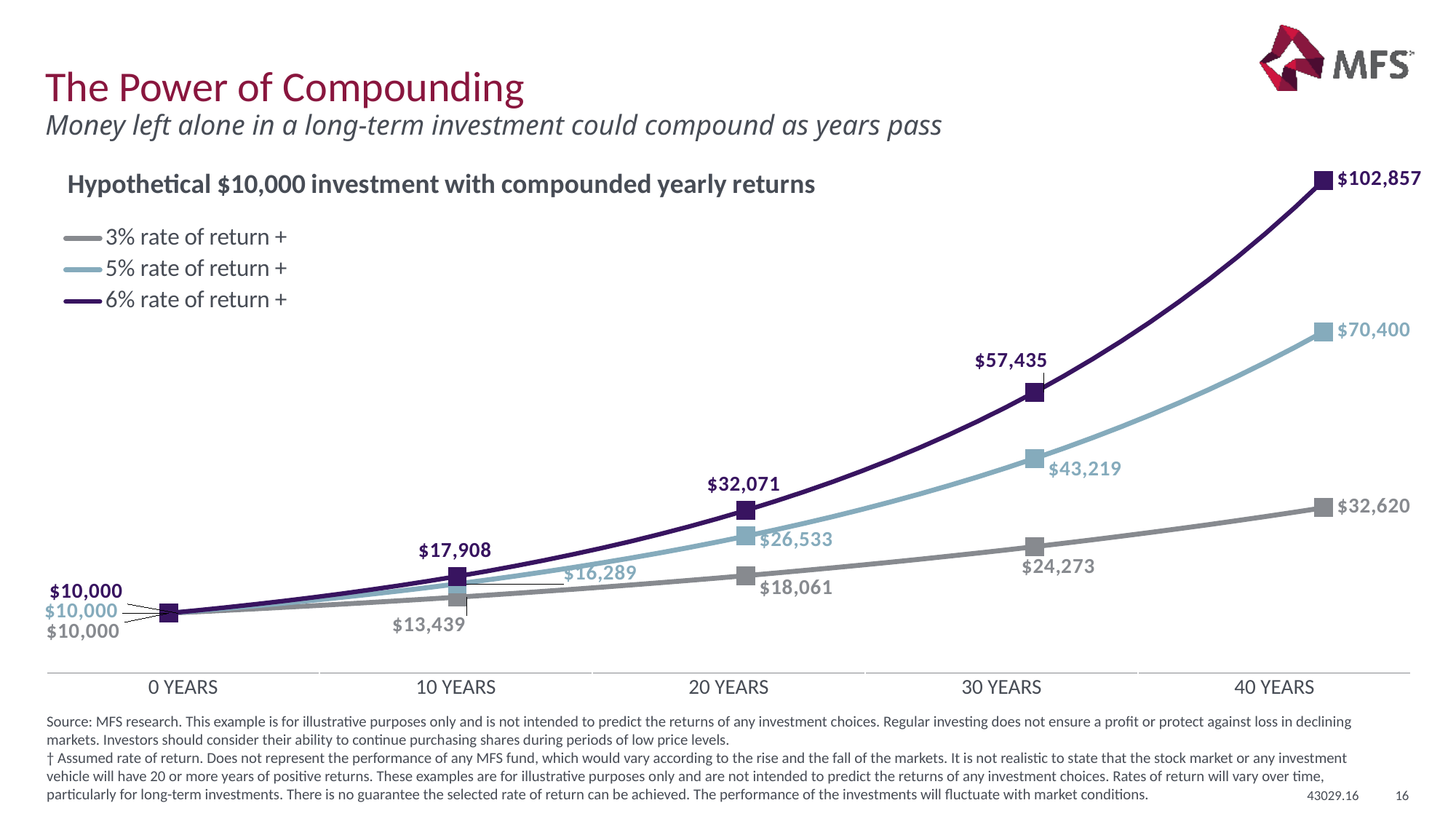
Which series has the lowest value at 30 years? 3% rate of return What is the value of the 6% rate of return series at 40 years? $102,857 Do the values of the 6% rate of return series rise or fall from 0 years to 40 years? Rise How many series does the legend list? 3 What kind of chart is shown on the slide? Line chart Which is larger at 20 years: the 5% rate of return value or the 3% rate of return value? 5% rate of return What is the value of the 5% rate of return series at 30 years? $43,219 What is the difference between the 5% and 3% rate of return values at 30 years? $18,946 What is the difference between the 6% and 5% rate of return values at 40 years? $32,457 Which series has the highest value at 40 years? 6% rate of return What is the value of the 3% rate of return series at 20 years? $18,061 What is the value of the 6% rate of return series at 10 years? $17,908